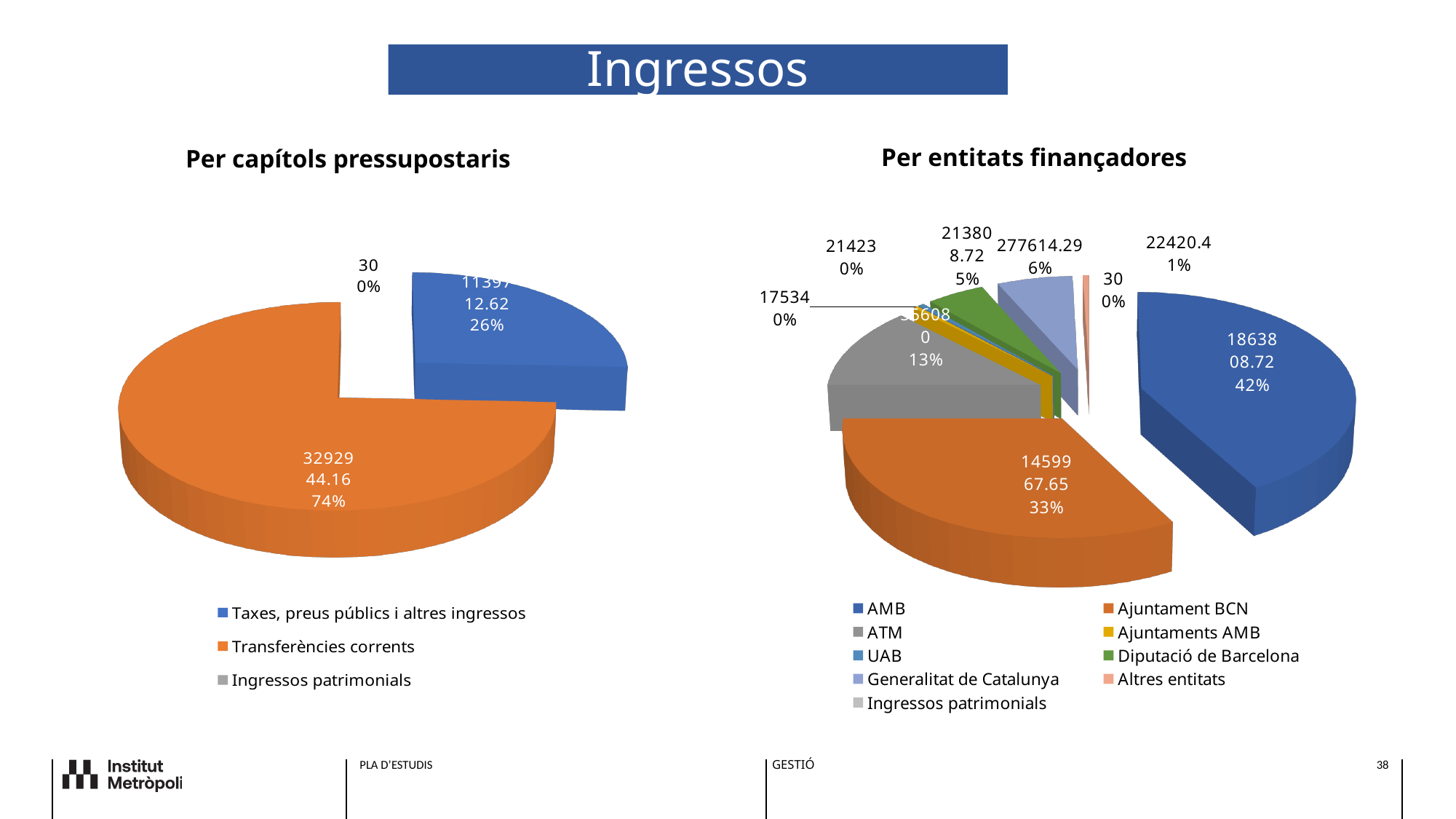
In the 'Per capítols pressupostaris' chart, what share does Transferències corrents have? 74% In the 'Per entitats finançadores' chart, what share does Ajuntament BCN have? 33% In the 'Per entitats finançadores' chart, which has the larger share, AMB or Ajuntament BCN? AMB How many entries does the legend of the 'Per capítols pressupostaris' chart list? 3 What kind of chart is the 'Per capítols pressupostaris' chart? Pie chart In the 'Per entitats finançadores' chart, what share does Generalitat de Catalunya have? 6% In the 'Per entitats finançadores' chart, what is the value shown for Altres entitats? 22420.4 In the 'Per capítols pressupostaris' chart, which category has the largest slice? Transferències corrents How many entries does the legend of the 'Per entitats finançadores' chart list? 9